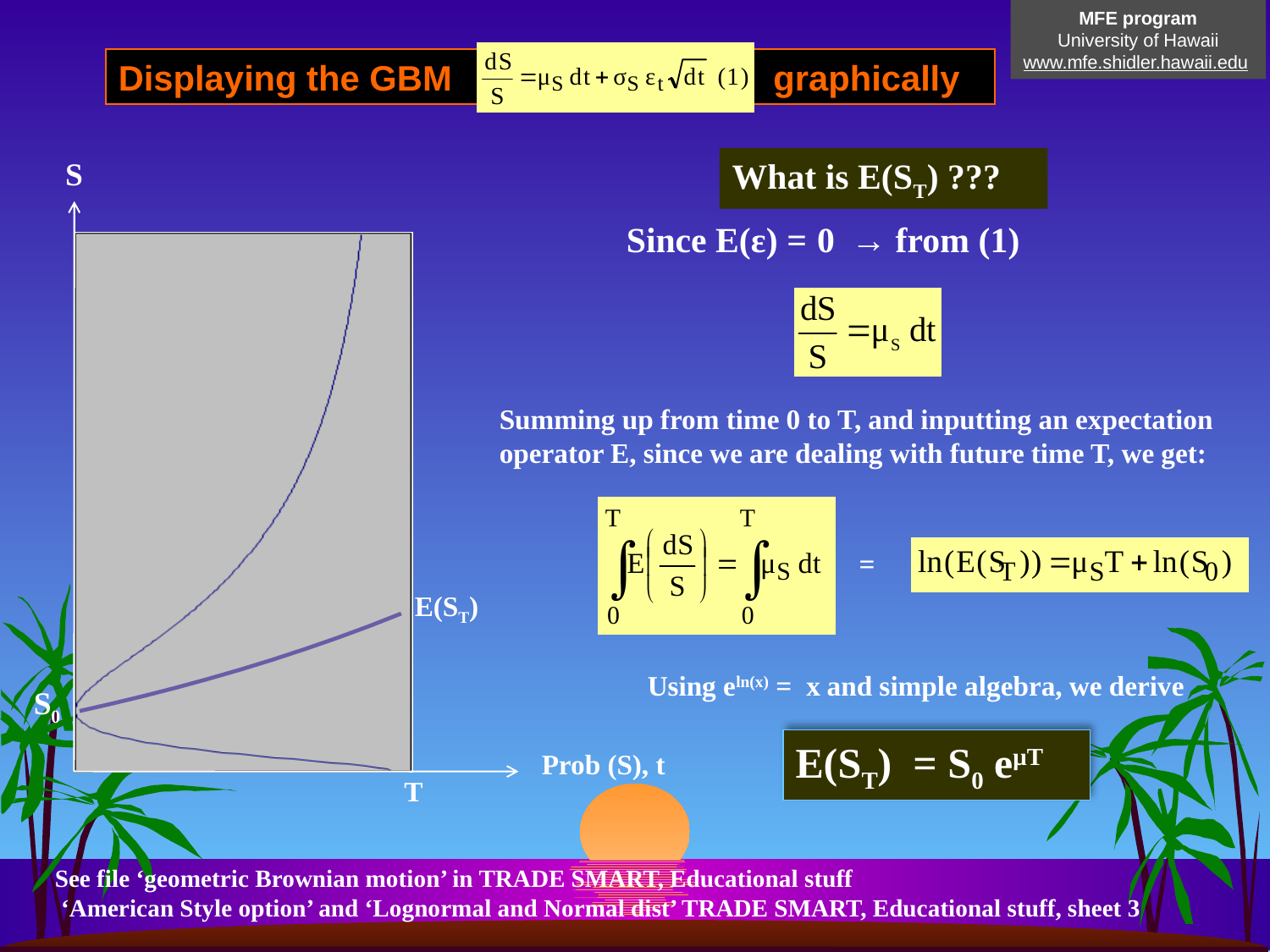
What label marks the starting point of the curves on the left side of the chart? S0 In the chart on the left, does the uppermost curve rise or fall as it moves to the right along the x axis? rise What kind of chart is shown on the left of the slide? line chart In the chart on the left, does the lowest curve rise or fall as it moves to the right along the x axis? fall In the chart on the left, does the thick line labelled E(S_T) rise or fall as it moves to the right along the x axis? rise In the chart on the left, which of the three curves is lowest at the right edge of the plot? the lower curve In the chart on the left, which of the three curves is highest at the right edge of the plot: the upper curve, the E(S_T) line, or the lower curve? the upper curve What label is on the vertical axis of the chart on the left? S How many curves are plotted in the chart on the left of the slide? 3